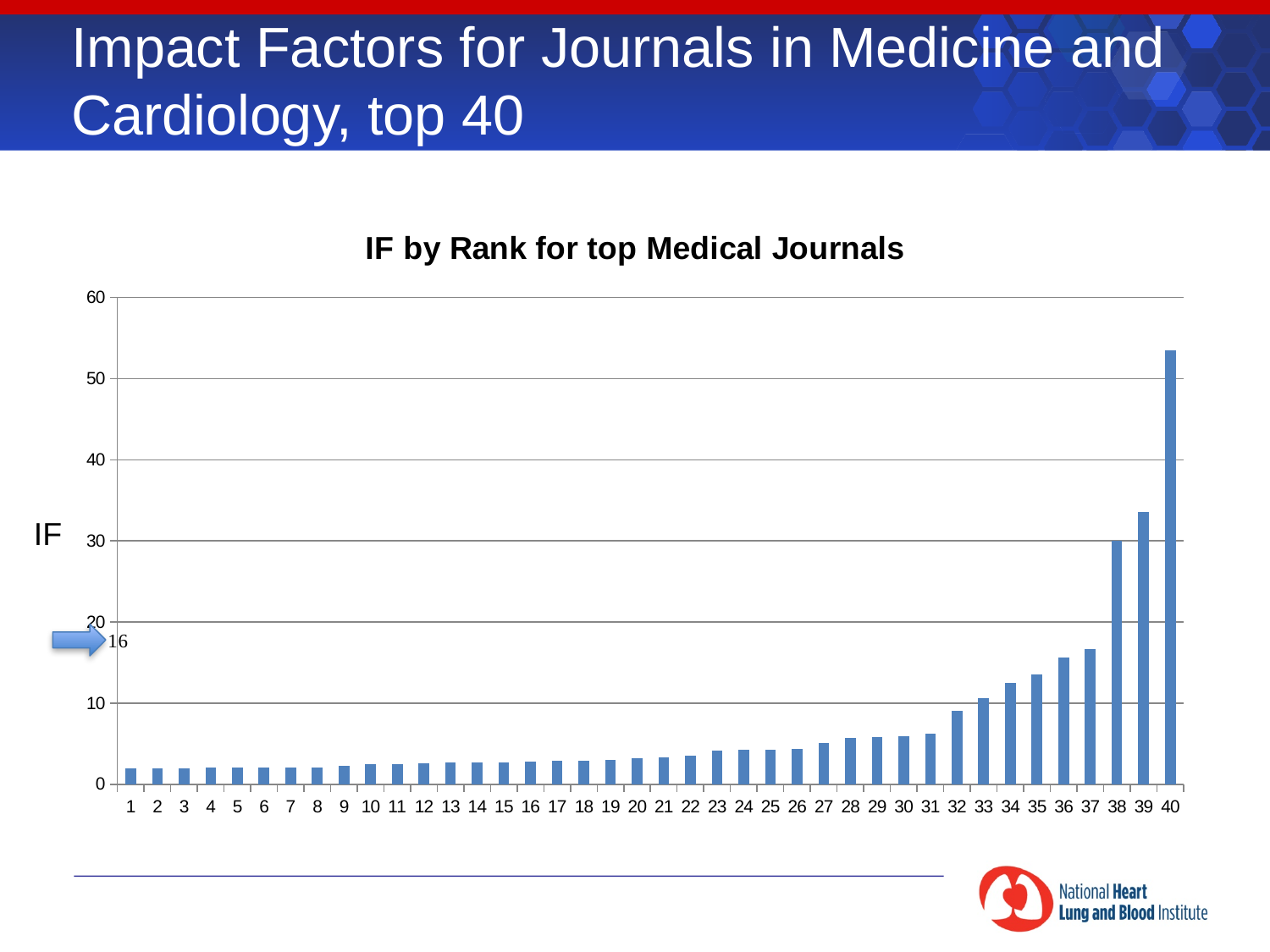
Is the value for rank 40 greater or less than 50? greater Which has the larger IF value, rank 10 or rank 30? rank 30 Which has the larger IF value, rank 39 or rank 40? rank 40 What is the title of the chart? IF by Rank for top Medical Journals Is the value for rank 37 greater or less than 20? less How many bars (ranks) are plotted in the chart? 40 Is the value for rank 39 greater or less than 30? greater Do the IF values rise or fall as rank increases from 1 to 40 along the x axis? rise What label is shown on the vertical axis of the chart? IF What kind of chart is shown on the slide? bar chart Which rank has the highest IF value in the chart? 40